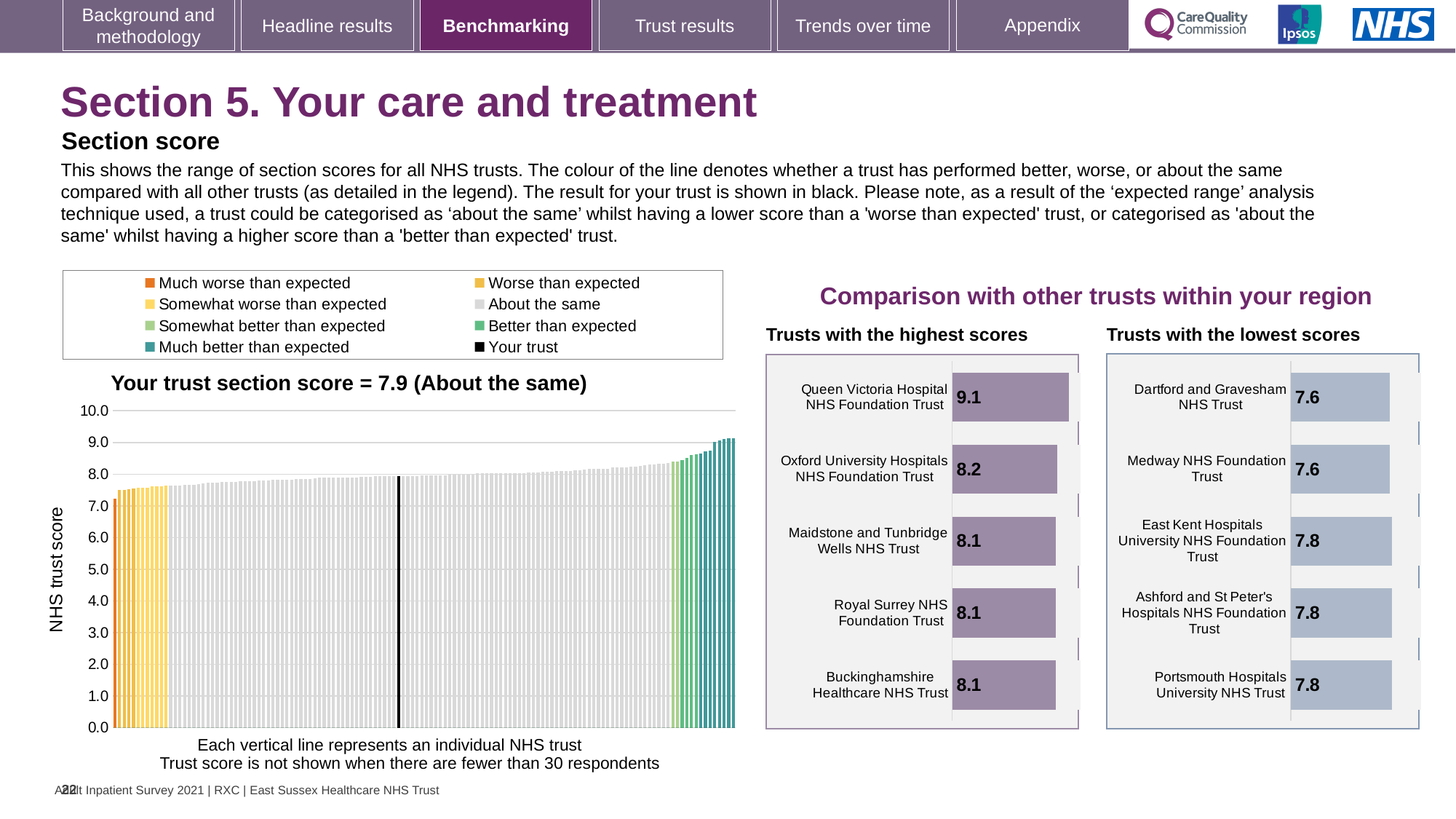
In the 'Trusts with the highest scores' chart, what is the difference between the scores of Queen Victoria Hospital NHS Foundation Trust and Oxford University Hospitals NHS Foundation Trust? 0.9 In the 'Trusts with the highest scores' chart, how many trusts are shown? 5 How many entries does the legend above the 'Your trust section score' chart list? 8 In the 'Trusts with the lowest scores' chart, what is the score for Dartford and Gravesham NHS Trust? 7.6 In the 'Trusts with the lowest scores' chart, which is larger: the score for Medway NHS Foundation Trust or East Kent Hospitals University NHS Foundation Trust? East Kent Hospitals University NHS Foundation Trust In the 'Trusts with the lowest scores' chart, what is the score for Portsmouth Hospitals University NHS Trust? 7.8 In the 'Your trust section score' chart, what is the section score for your trust? 7.9 In the 'Your trust section score' chart, do the trust scores rise or fall from left to right? rise In the 'Trusts with the highest scores' chart, what is the score for Queen Victoria Hospital NHS Foundation Trust? 9.1 In the 'Trusts with the lowest scores' chart, what is the difference between the scores of Portsmouth Hospitals University NHS Trust and Dartford and Gravesham NHS Trust? 0.2 In the 'Trusts with the highest scores' chart, what is the score for Oxford University Hospitals NHS Foundation Trust? 8.2 In the 'Trusts with the highest scores' chart, which trust has the highest score? Queen Victoria Hospital NHS Foundation Trust